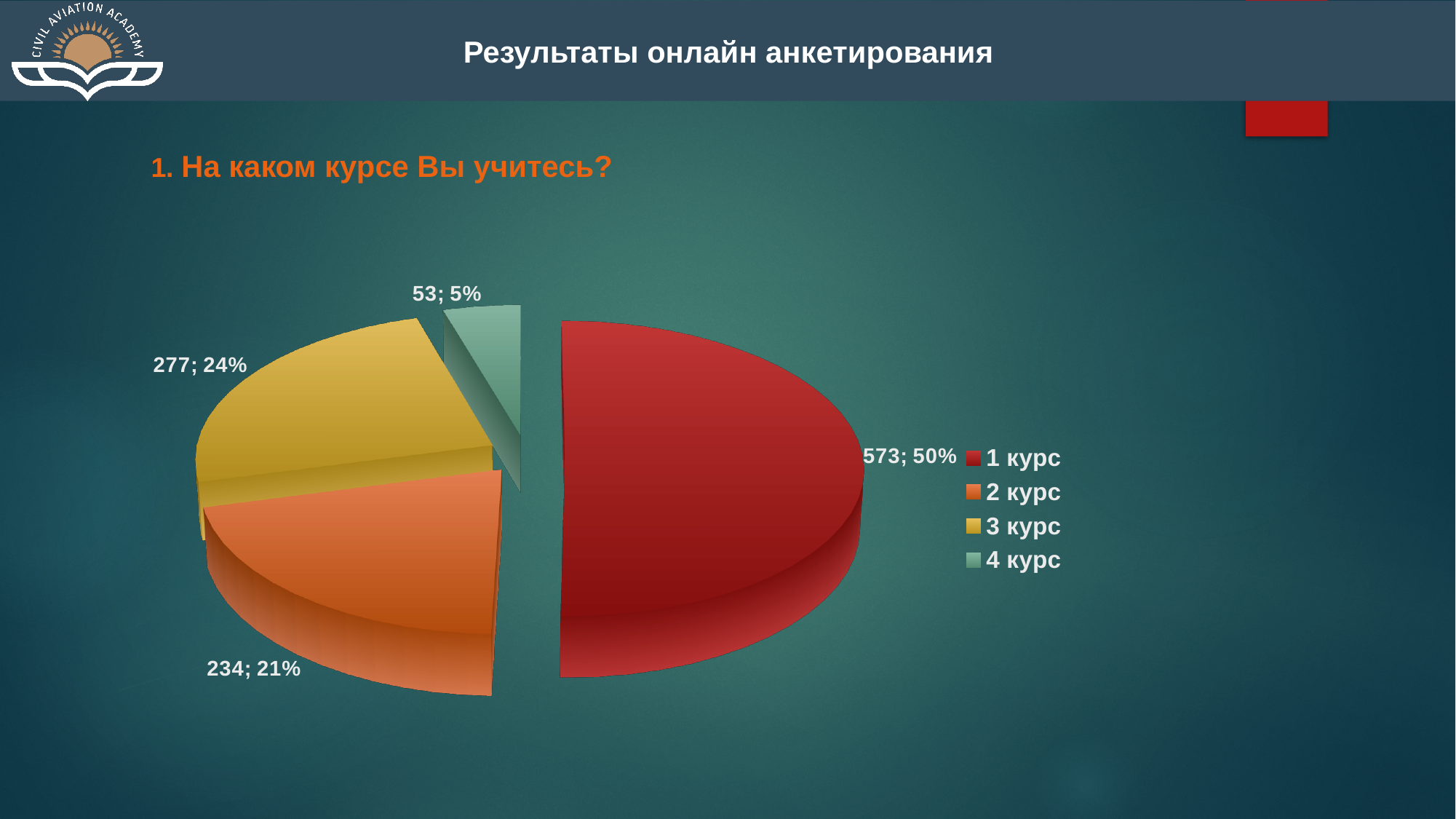
How many slices does the pie chart have? 4 What is the difference between the values for 1 курс and 3 курс? 296 What is the value for 3 курс? 277 Which category has the largest slice? 1 курс Which category has the smallest slice? 4 курс What share of the pie does 2 курс represent? 21% What is the value for 1 курс? 573 What kind of chart is shown on the slide? pie chart What is the value for 4 курс? 53 How many entries does the legend list? 4 What share of the pie does 1 курс represent? 50% Which is larger, the value for 2 курс or the value for 3 курс? 3 курс